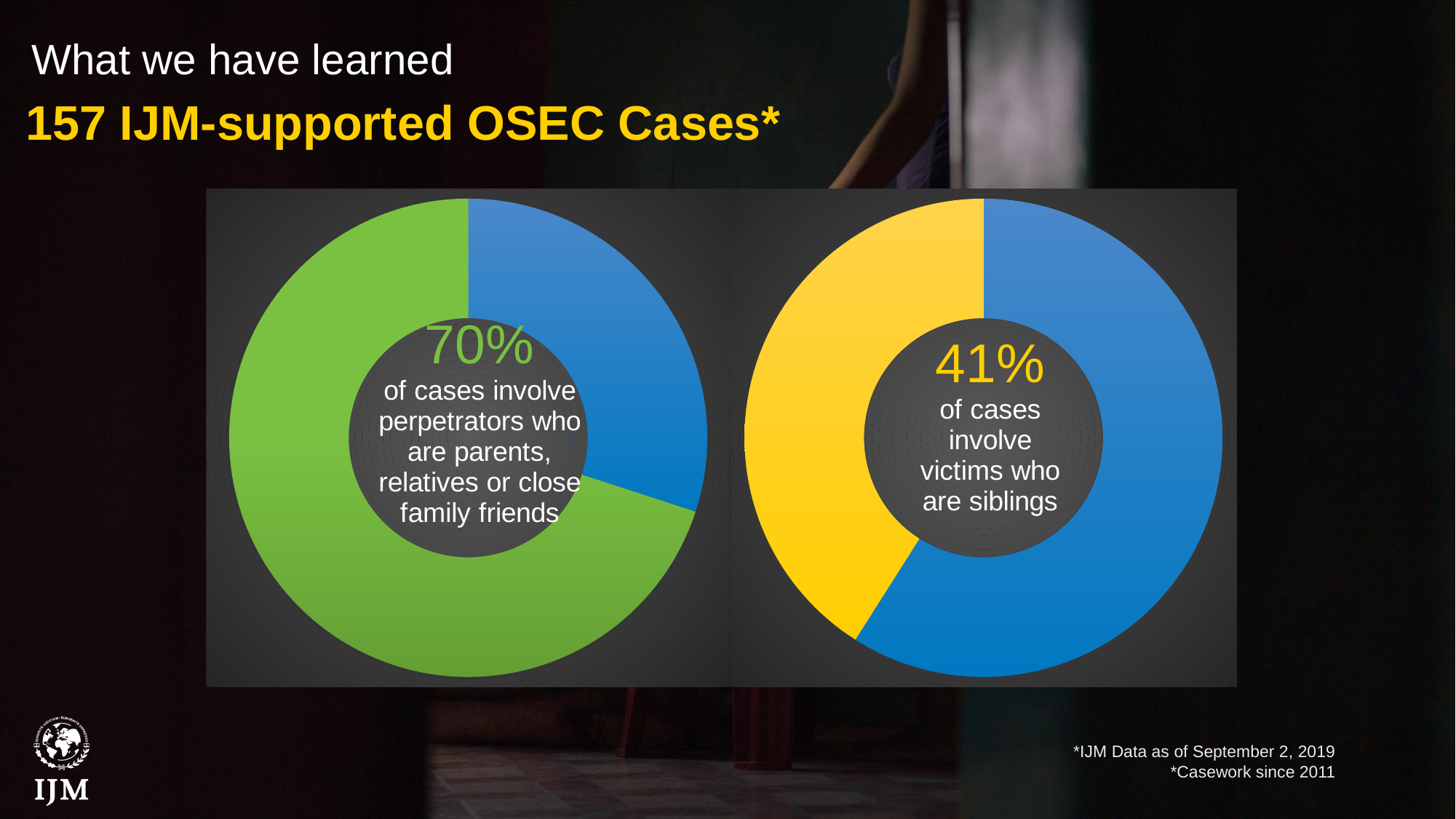
In the right chart, what percentage of cases involve victims who are siblings? 41% What kind of charts are shown on the slide? Donut (pie) charts Which chart shows the larger highlighted share: the left chart (perpetrators who are family) or the right chart (victims who are siblings)? The left chart In the left chart, which slice is larger: the green slice or the blue slice? The green slice What colour is the slice representing the 70% of cases in the left chart? Green In the right chart, which slice is larger: the yellow slice or the blue slice? The blue slice In the left chart, what percentage of cases involve perpetrators who are parents, relatives or close family friends? 70% In the left chart, is the share of cases involving perpetrators who are parents, relatives or close family friends greater or less than 50%? greater How many slices does each donut chart have? 2 In the right chart, is the share of cases involving victims who are siblings greater or less than 50%? less How many charts are on the slide? 2 How many IJM-supported OSEC cases does the slide title say the data covers? 157